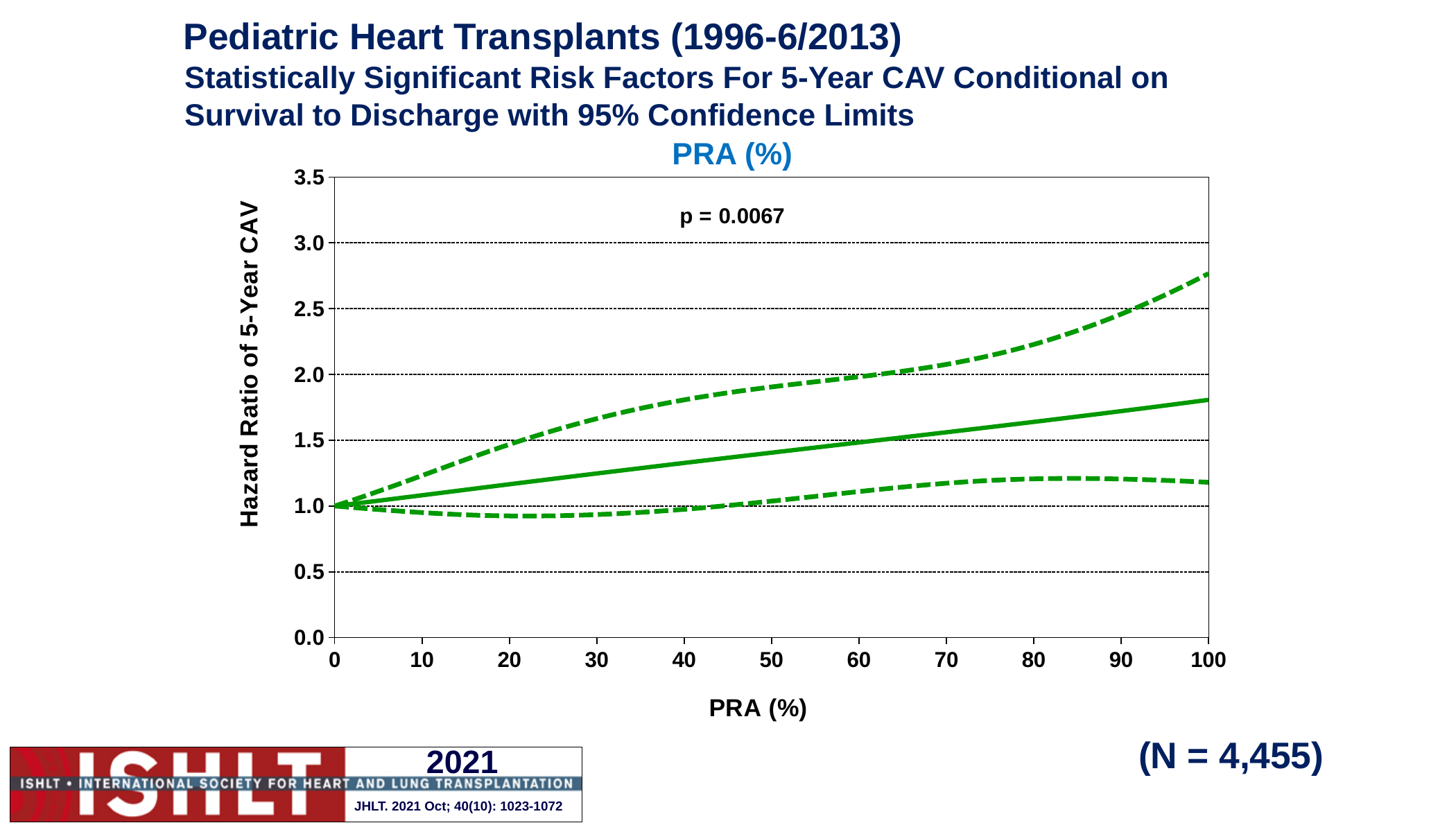
What kind of chart is shown on the slide? line chart Does the solid hazard ratio line rise or fall as PRA (%) increases from 0 to 100? rises Is the hazard ratio on the solid line at a PRA of 100% greater or less than 1.5? greater What is the hazard ratio of 5-year CAV at a PRA of 0%? 1.0 What p-value is printed on the chart? p = 0.0067 Is the upper dashed confidence limit at a PRA of 100% greater or less than 2.5? greater Is the lower dashed confidence limit at a PRA of 20% greater or less than 1.0? less What sample size (N) is shown on the slide? N = 4,455 How many lines are plotted on the chart? 3